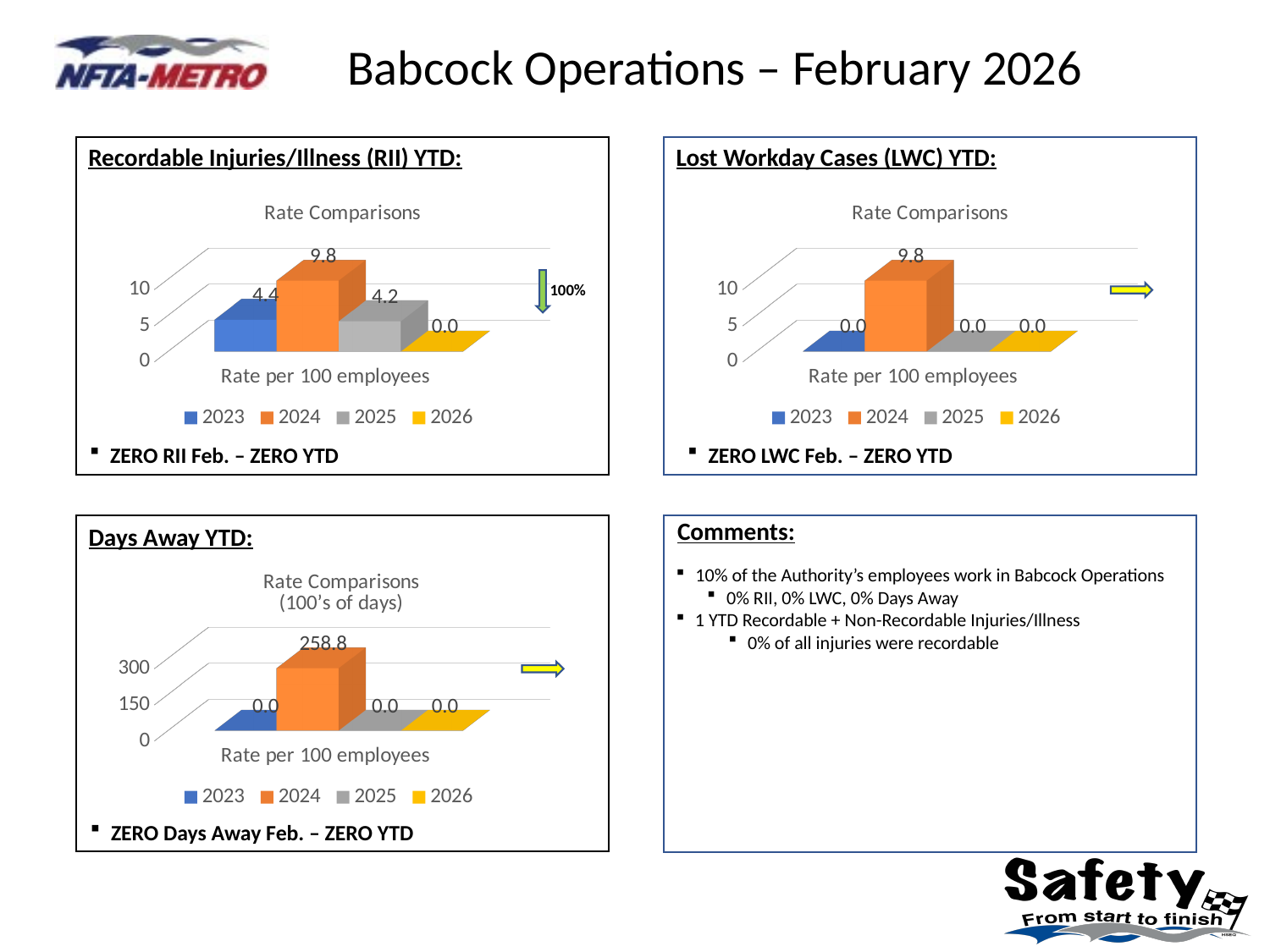
In the Recordable Injuries/Illness (RII) YTD chart, what is the value for 2024? 9.8 In the Days Away YTD chart, what is the value for 2024? 258.8 What kind of chart is the Lost Workday Cases (LWC) YTD chart? Bar chart In the Recordable Injuries/Illness (RII) YTD chart, what is the value for 2023? 4.4 How many series does the legend of the Days Away YTD chart list? 4 In the Days Away YTD chart, which year has the highest value? 2024 In the Recordable Injuries/Illness (RII) YTD chart, what is the difference between the 2024 and 2023 values? 5.4 In the Lost Workday Cases (LWC) YTD chart, what is the value for 2026? 0.0 In the Recordable Injuries/Illness (RII) YTD chart, what is the value for 2025? 4.2 In the Recordable Injuries/Illness (RII) YTD chart, which is larger, the value for 2023 or the value for 2025? 2023 In the Lost Workday Cases (LWC) YTD chart, what is the value for 2024? 9.8 In the Recordable Injuries/Illness (RII) YTD chart, which year has the highest value? 2024